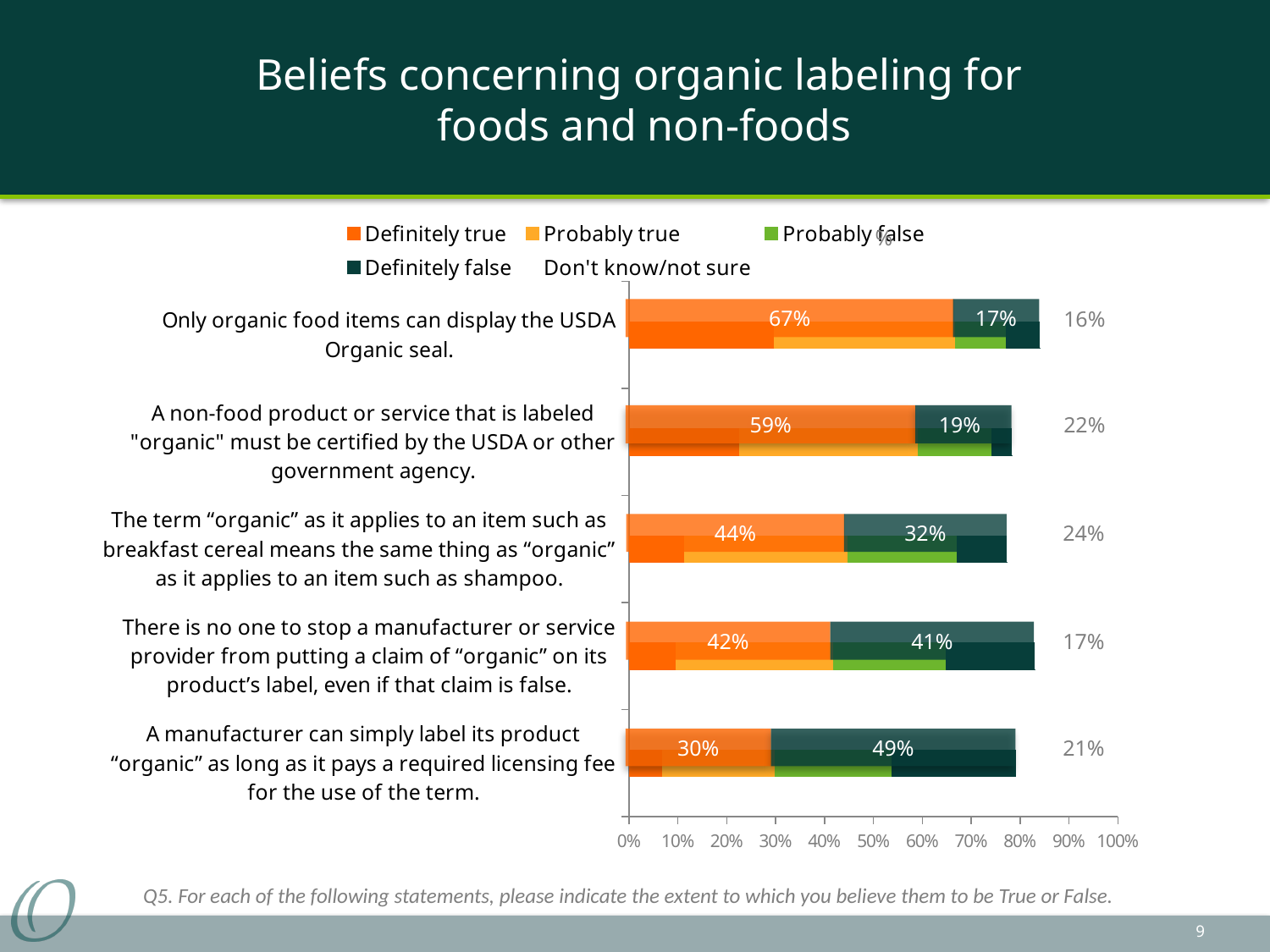
For the statement "There is no one to stop a manufacturer or service provider from putting a claim of 'organic' on its product's label, even if that claim is false", which is larger: the orange (true) percentage or the green (false) percentage? The orange (true) percentage, 42% What percentage label is printed on the orange (true) portion of the bar for "Only organic food items can display the USDA Organic seal"? 67% What is the grey percentage printed to the right of the bar for "The term 'organic' as it applies to an item such as breakfast cereal means the same thing as 'organic' as it applies to an item such as shampoo"? 24% What is the difference between the orange (true) percentage for the USDA Organic seal statement (67%) and the orange (true) percentage for the licensing fee statement (30%)? 37 percentage points What percentage label is printed on the green (false) portion of the bar for "A manufacturer can simply label its product 'organic' as long as it pays a required licensing fee for the use of the term"? 49% What percentage label is printed on the green (false) portion of the bar for "A non-food product or service that is labeled 'organic' must be certified by the USDA or other government agency"? 19% How many series does the legend list? 5 Which statement has the highest percentage printed on its orange (true) portion? Only organic food items can display the USDA Organic seal. Which statement has the lowest percentage printed on its orange (true) portion? A manufacturer can simply label its product "organic" as long as it pays a required licensing fee for the use of the term. How many statements (categories) are plotted in the chart? 5 What kind of chart is shown on the slide? Stacked bar chart What is the title of the chart on the slide? Beliefs concerning organic labeling for foods and non-foods